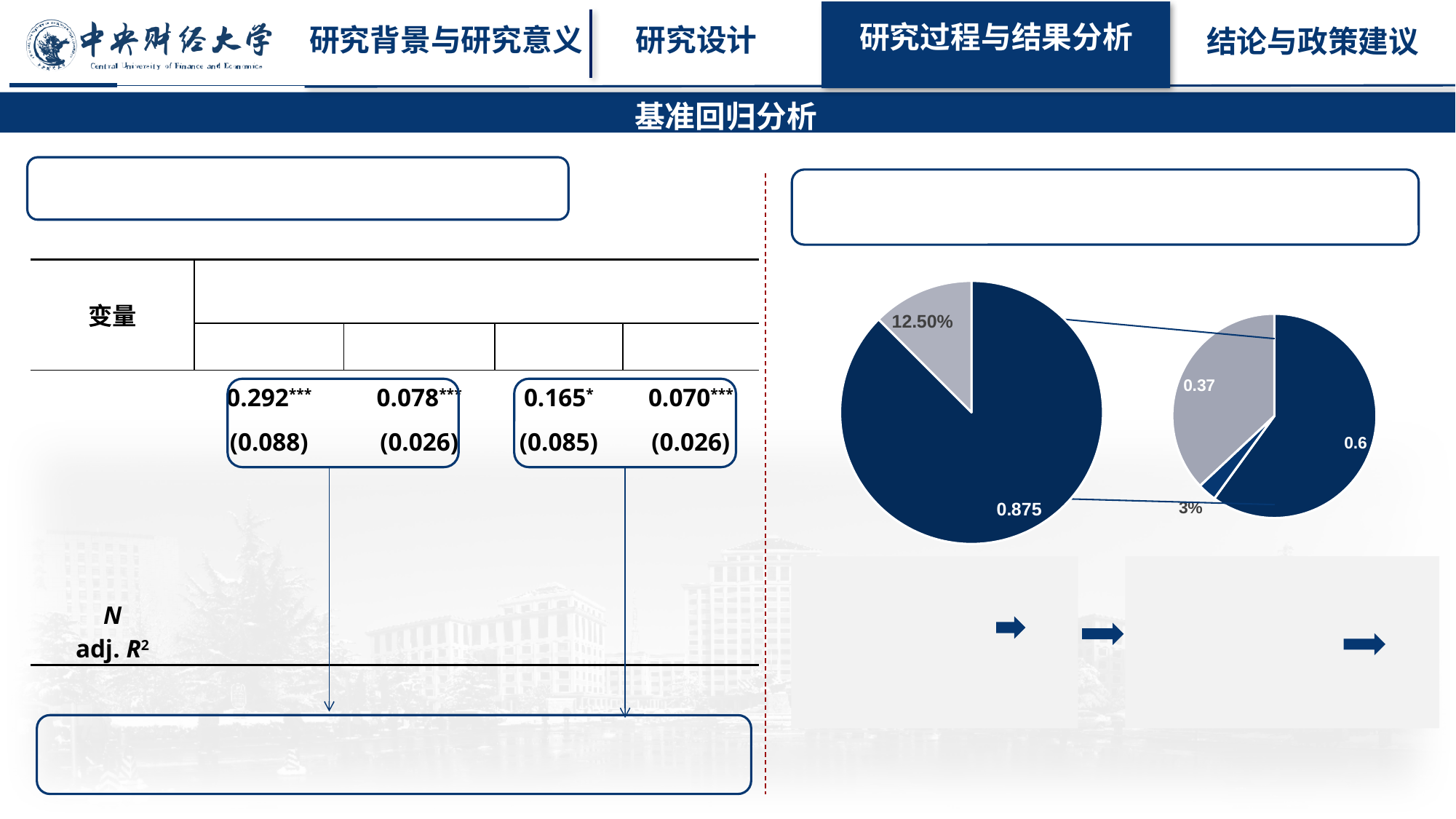
What value is printed on the largest slice of the main pie? 0.875 What colour is the slice labelled 12.50% in the main pie? grey How many slices does the large (main) pie on the right have? 2 What value is printed on the largest slice of the secondary pie? 0.6 What value is printed on the smallest slice of the secondary pie? 3% What value is printed on the smaller slice of the main pie? 12.50% How many data labels are printed across both pies on the right? 5 What kind of chart is shown on the right side of the slide? pie chart In the secondary pie, which slice is larger: the one labelled 0.37 or the one labelled 0.6? 0.6 How many slices does the smaller secondary pie on the right have? 3 In the main pie, which slice is larger: the one labelled 12.50% or the one labelled 0.875? 0.875 What colour is the largest slice of the main pie? dark blue